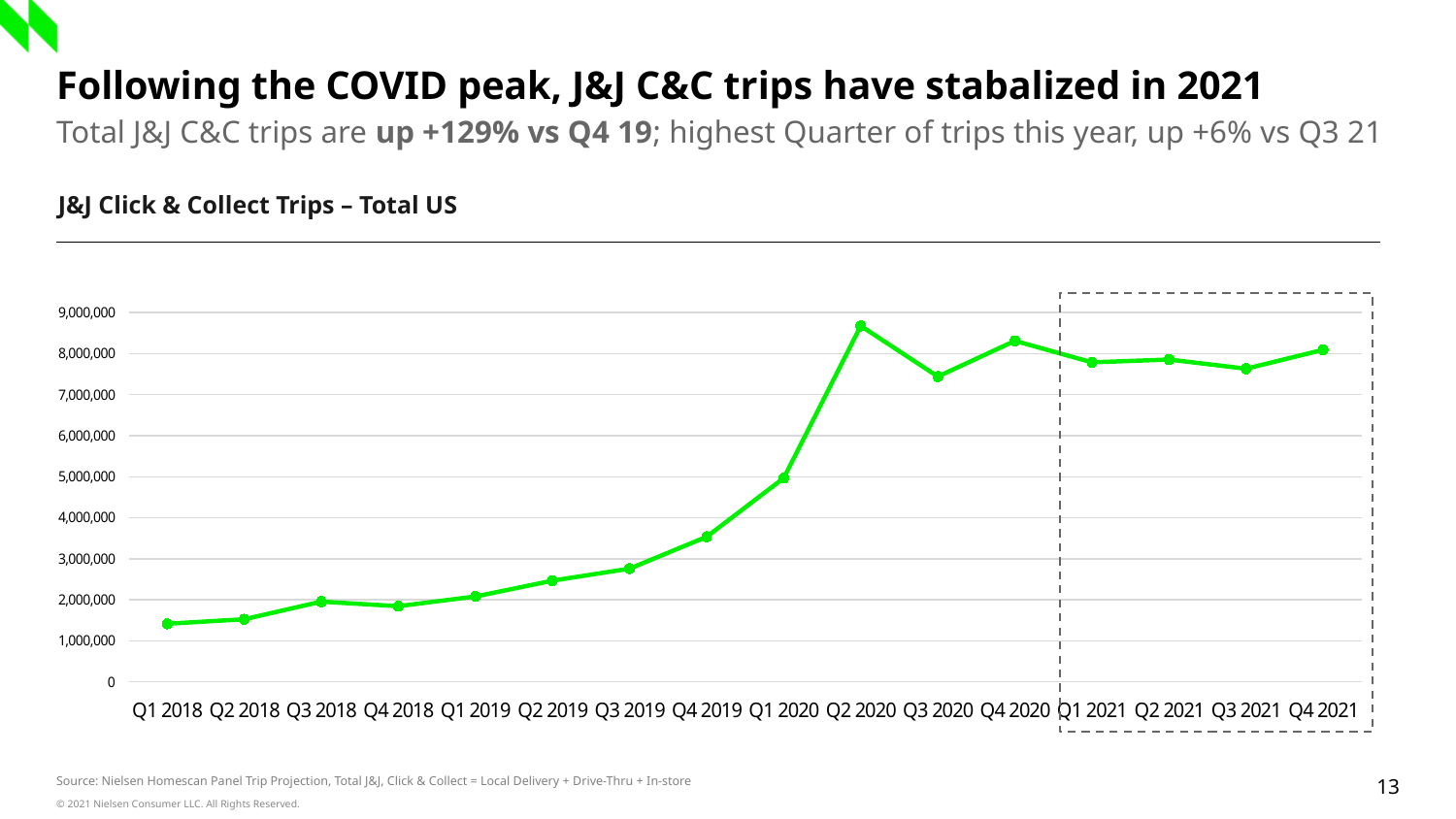
What is the title of the chart? J&J Click & Collect Trips – Total US Is the value for Q1 2020 greater or less than 4,000,000? greater Which quarter has the highest number of J&J Click & Collect trips? Q2 2020 How many quarters are plotted on the x axis of the chart? 16 Which is larger, the value for Q2 2020 or the value for Q3 2020? Q2 2020 Is the value for Q1 2018 greater or less than 2,000,000? less Which is larger, the value for Q4 2020 or the value for Q3 2021? Q4 2020 Is the value for Q2 2020 greater or less than 8,000,000? greater Do the values rise or fall from Q1 2018 to Q2 2020? Rise What kind of chart is shown on the slide? Line chart